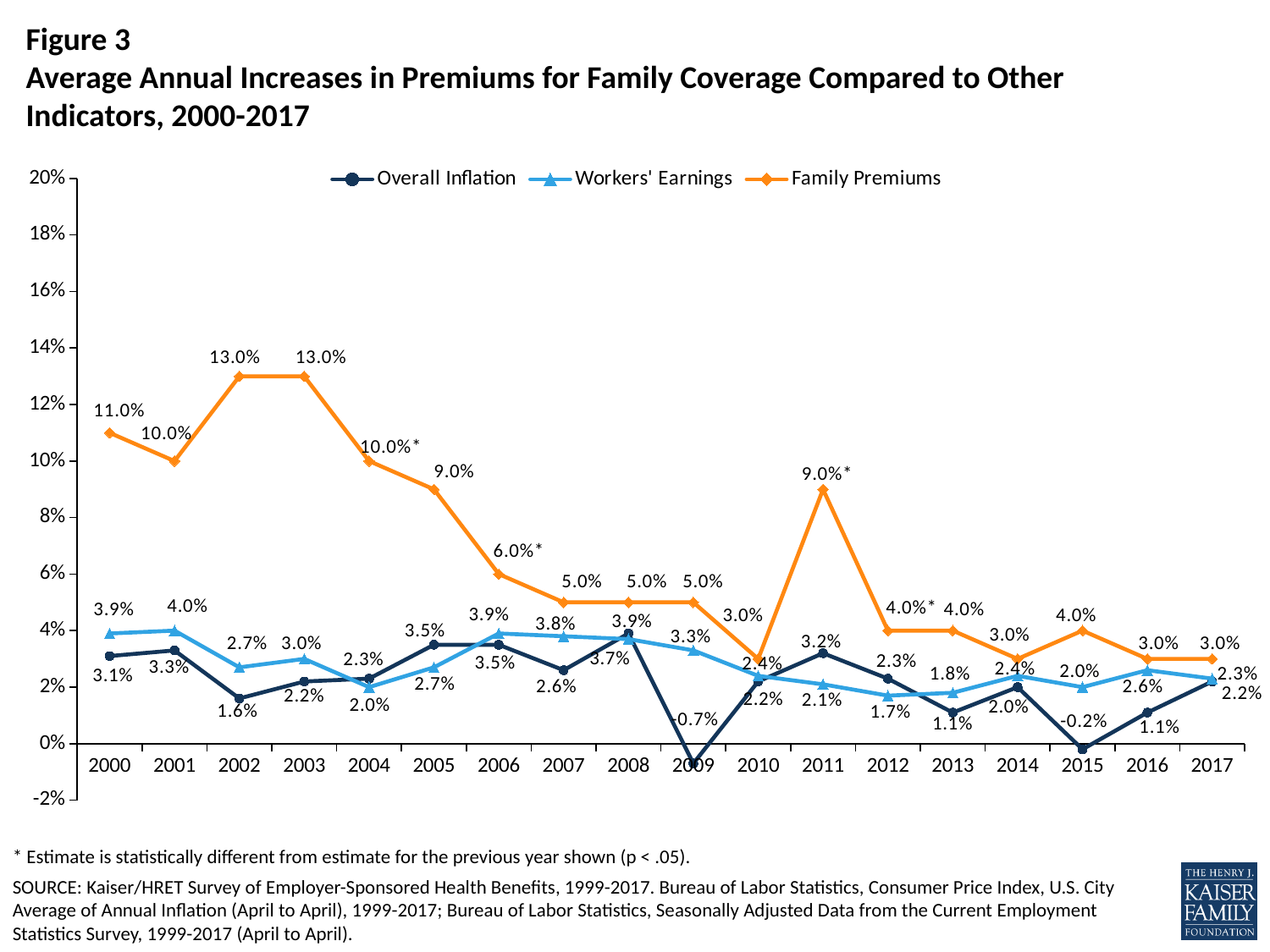
What is the Workers' Earnings value for 2012? 1.7% What kind of chart is this? line chart In which year is Overall Inflation at its lowest? 2009 What is the highest Family Premiums value shown on the chart? 13.0% What is the difference between Family Premiums and Workers' Earnings in 2000? 7.1 percentage points What is the Overall Inflation value for 2009? -0.7% In 2011, which is larger: Family Premiums or Overall Inflation? Family Premiums Is the Family Premiums value for 2002 greater or less than 12%? greater How many series does the legend list? 3 How many years are shown on the x axis? 18 Do Family Premiums rise or fall from 2003 to 2010? fall What is the Family Premiums value for 2000? 11.0%